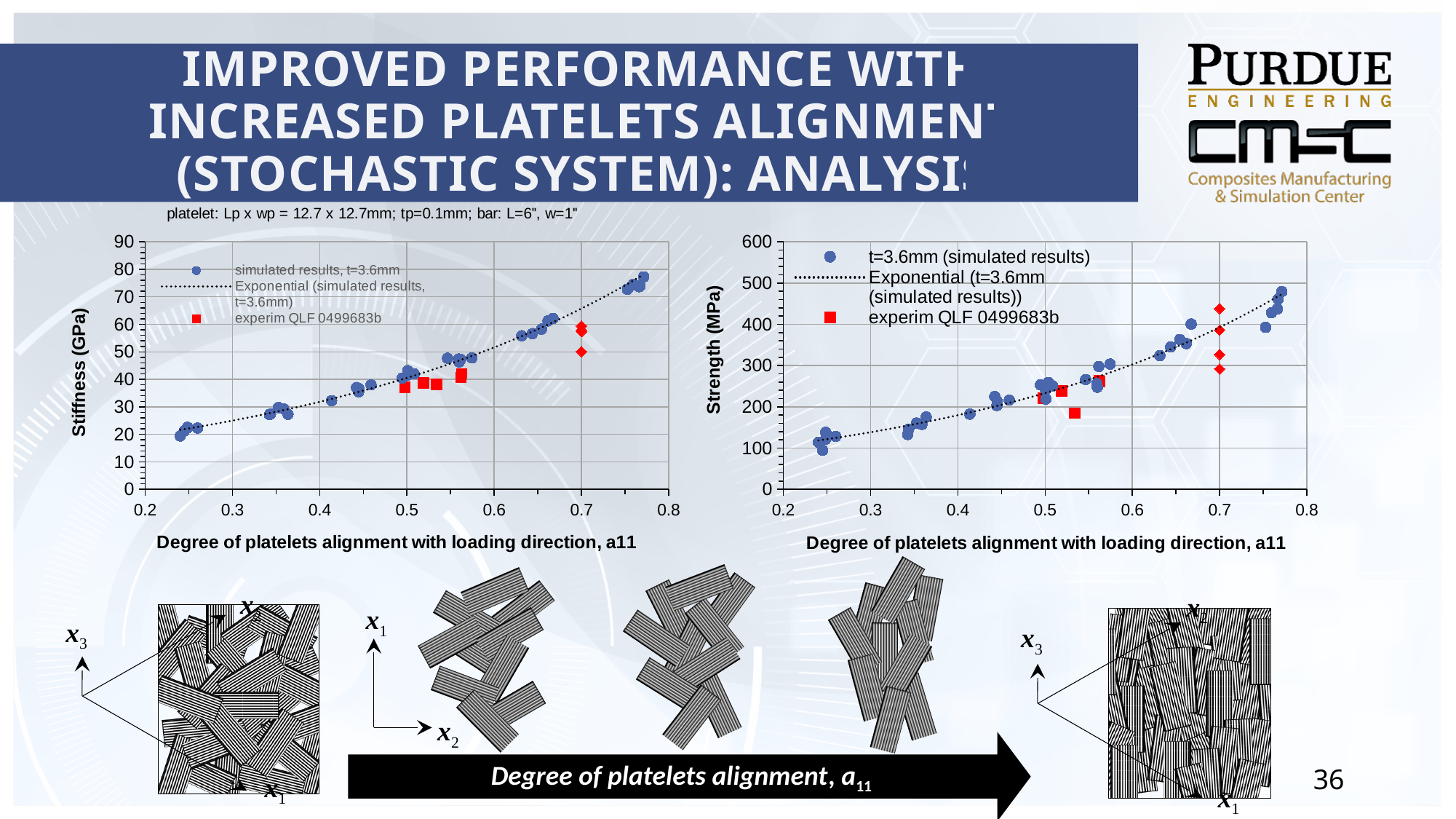
How many entries does the legend of the right chart list? 3 In the left chart, are the simulated stiffness values at a11 of about 0.77 greater or less than 70 GPa? greater In the right chart, are the simulated strength values at a11 of about 0.25 greater or less than 200 MPa? less In the left chart, are the simulated stiffness values at a11 of about 0.24 greater or less than 30 GPa? less What is the y-axis label of the right chart? Strength (MPa) In the left chart, do the simulated stiffness values rise or fall as the degree of platelets alignment a11 increases? rise What kind of chart is the right chart (Strength vs degree of platelets alignment)? scatter chart In the right chart, do the simulated strength values rise or fall as the degree of platelets alignment a11 increases? rise What is the x-axis label of the left chart? Degree of platelets alignment with loading direction, a11 What kind of chart is the left chart (Stiffness vs degree of platelets alignment)? scatter chart How many entries does the legend of the left chart list? 3